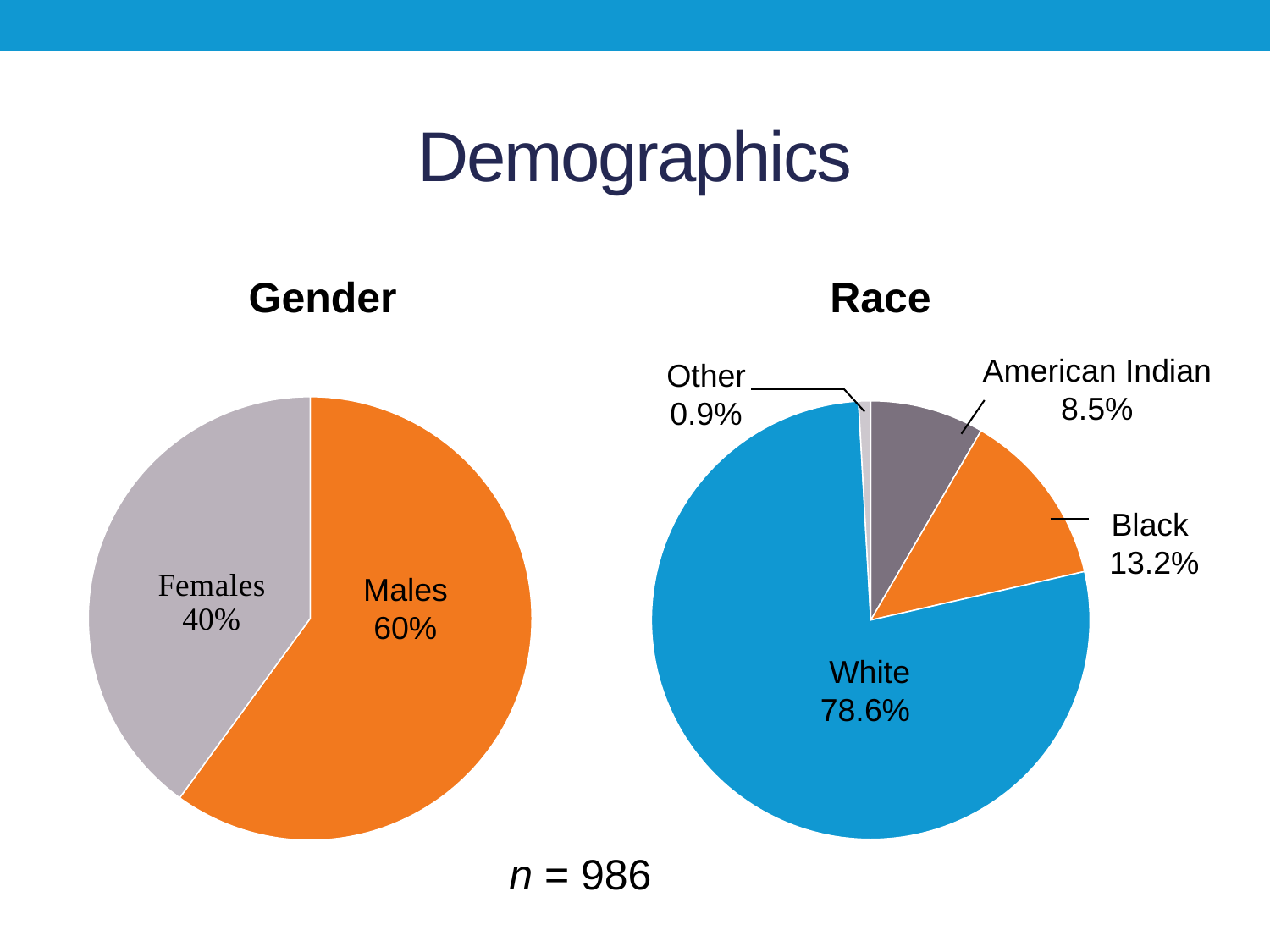
In the Gender chart, what share of the pie is Males? 60% In the Race chart, what is the value for White? 78.6% In the Gender chart, which category is larger, Males or Females? Males In the Race chart, which category has the smallest share? Other In the Gender chart, what is the difference between the Males and Females shares? 20% What type of chart is the Gender chart? Pie chart In the Race chart, how many categories are shown? 4 In the Gender chart, what is the value for Females? 40% In the Race chart, what is the value for Black? 13.2% In the Race chart, what is the value for American Indian? 8.5% In the Race chart, what is the difference between the Black and American Indian shares? 4.7% In the Race chart, which category has the largest share? White